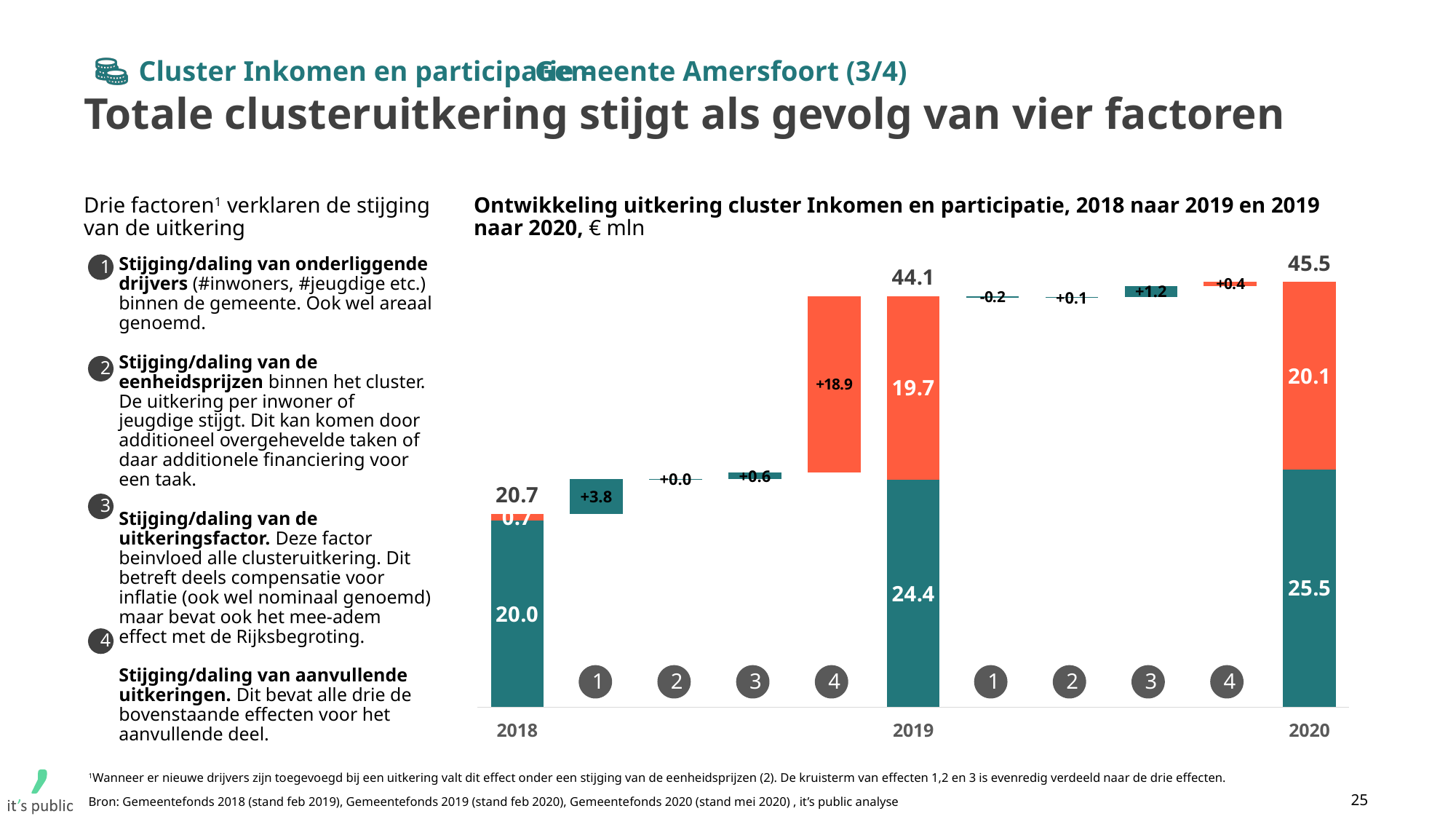
How many year totals (2018, 2019, 2020) are shown on the chart? 3 Do the year totals rise or fall from 2018 to 2020? Rise Which of the four steps between 2018 and 2019 has the largest value? Step 4 (+18.9) Is the teal segment larger in the 2019 bar or in the 2020 bar? 2020 What is the value of the orange (upper) segment of the 2019 bar? 19.7 What is the difference between the 2020 total (45.5) and the 2018 total (20.7)? 24.8 Which of the four steps between 2019 and 2020 has the lowest value? Step 1 (-0.2) What is the value of the teal (lower) segment of the 2020 bar? 25.5 What is the total uitkering for 2020 shown on the chart? 45.5 What is the total uitkering for 2018 shown on the chart? 20.7 What is the value of step 4 between 2018 and 2019? +18.9 What is the total uitkering for 2019 shown on the chart? 44.1